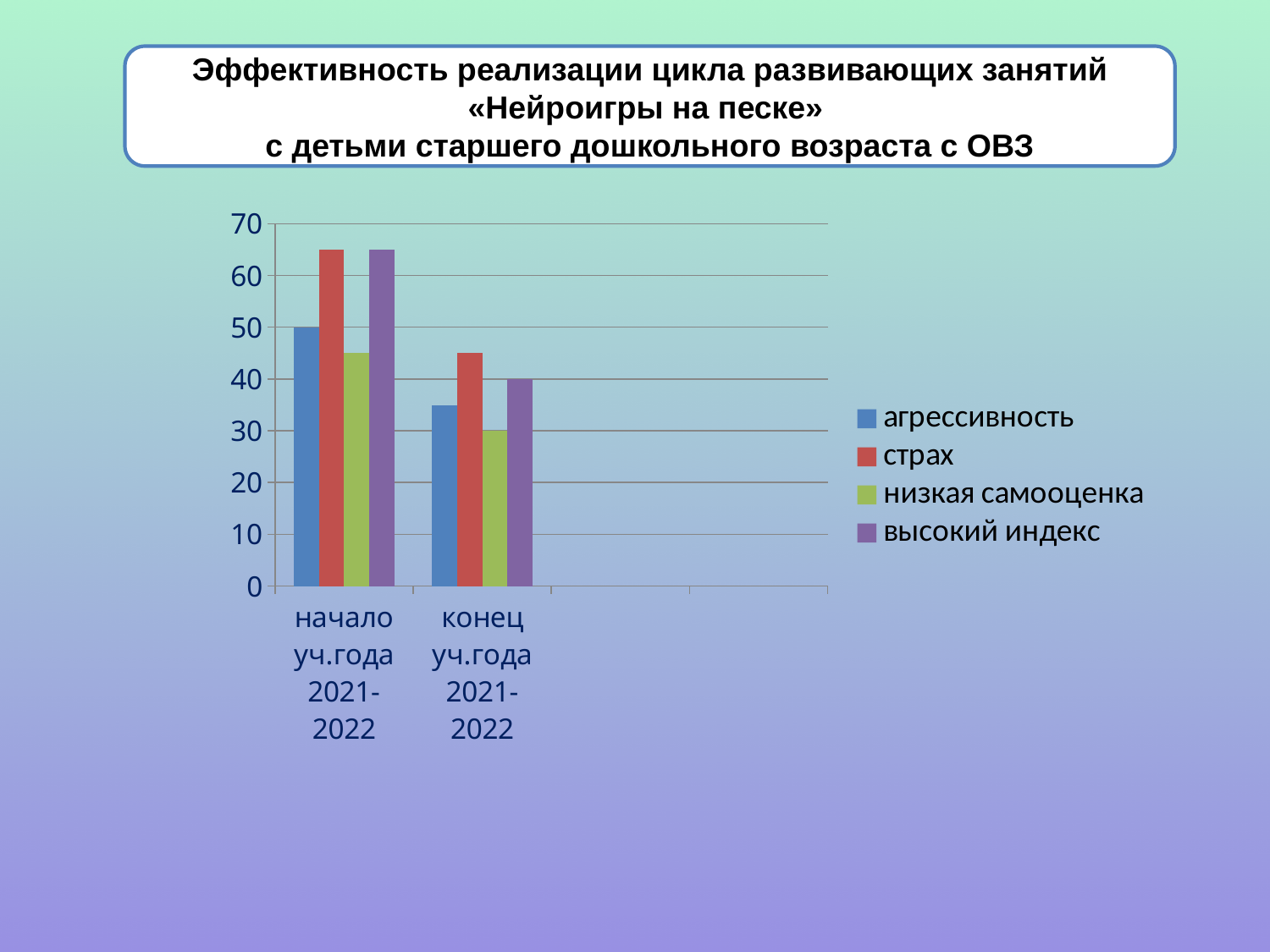
Is the value for страх at начало уч.года 2021-2022 greater or less than 60? greater What is the value for агрессивность at начало уч.года 2021-2022? 50 How many categories are shown on the x axis? 2 Is the value for агрессивность at конец уч.года 2021-2022 greater or less than 40? less Which series has the lowest value at конец уч.года 2021-2022? низкая самооценка What kind of chart is shown on the slide? bar chart How many series does the legend list? 4 What is the value for высокий индекс at конец уч.года 2021-2022? 40 What is the value for низкая самооценка at конец уч.года 2021-2022? 30 Do the values for страх rise or fall from начало уч.года to конец уч.года 2021-2022? fall Which is larger at начало уч.года 2021-2022: агрессивность or страх? страх Is the value for низкая самооценка at начало уч.года 2021-2022 greater or less than 50? less